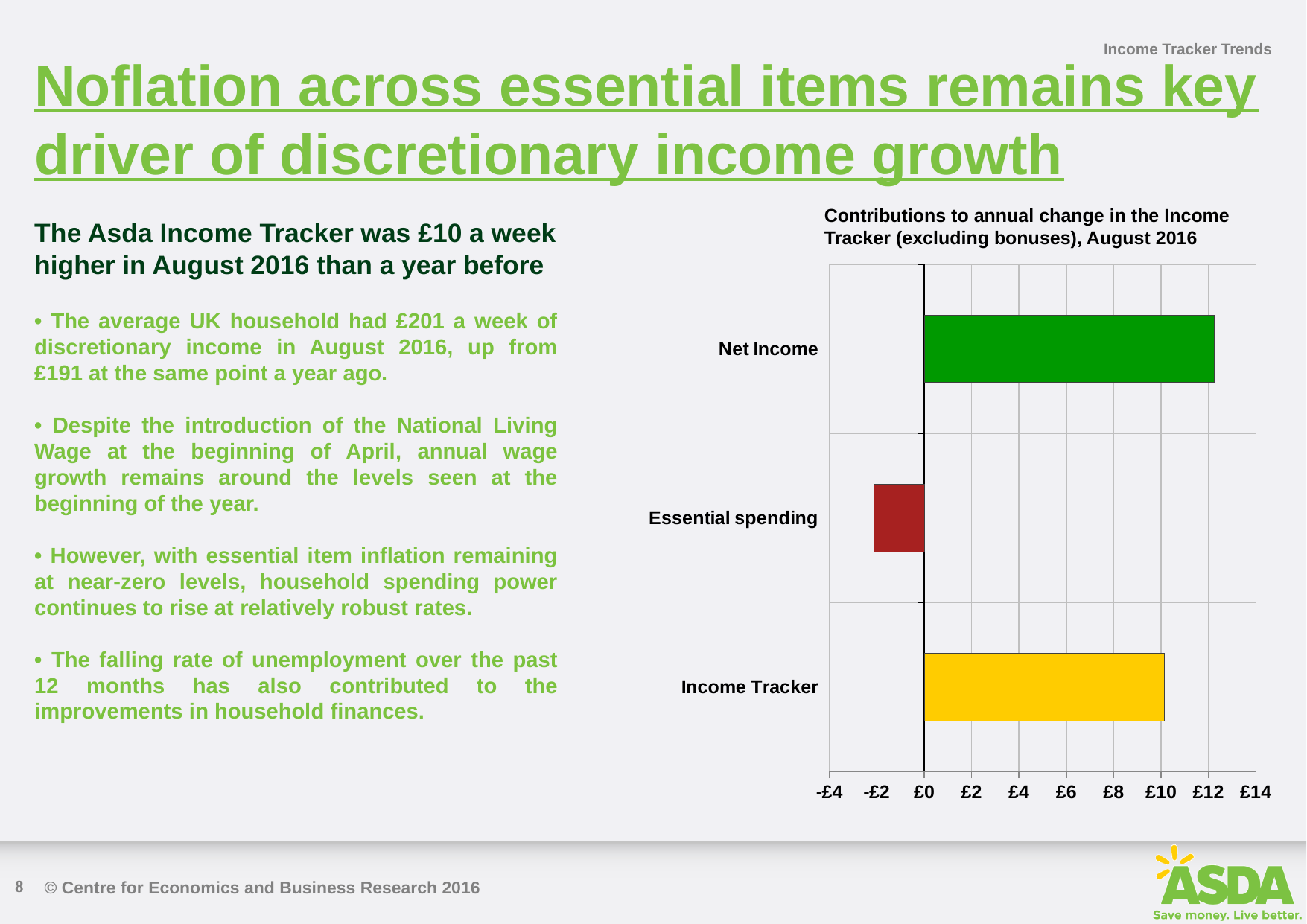
Which is larger, the value for Net Income or the value for Income Tracker? Net Income What kind of chart is shown on the slide? Bar chart Is the value for Income Tracker greater or less than £8? greater Is the value for Net Income greater or less than £10? greater How many categories are plotted in the chart? 3 Is the value for Essential spending greater or less than -£4? greater What is the title of the chart? Contributions to annual change in the Income Tracker (excluding bonuses), August 2016 Which is larger, the value for Essential spending or the value for Income Tracker? Income Tracker Which category has the highest value in the chart? Net Income Which category has the lowest value in the chart? Essential spending What colour is the bar for Essential spending? Red